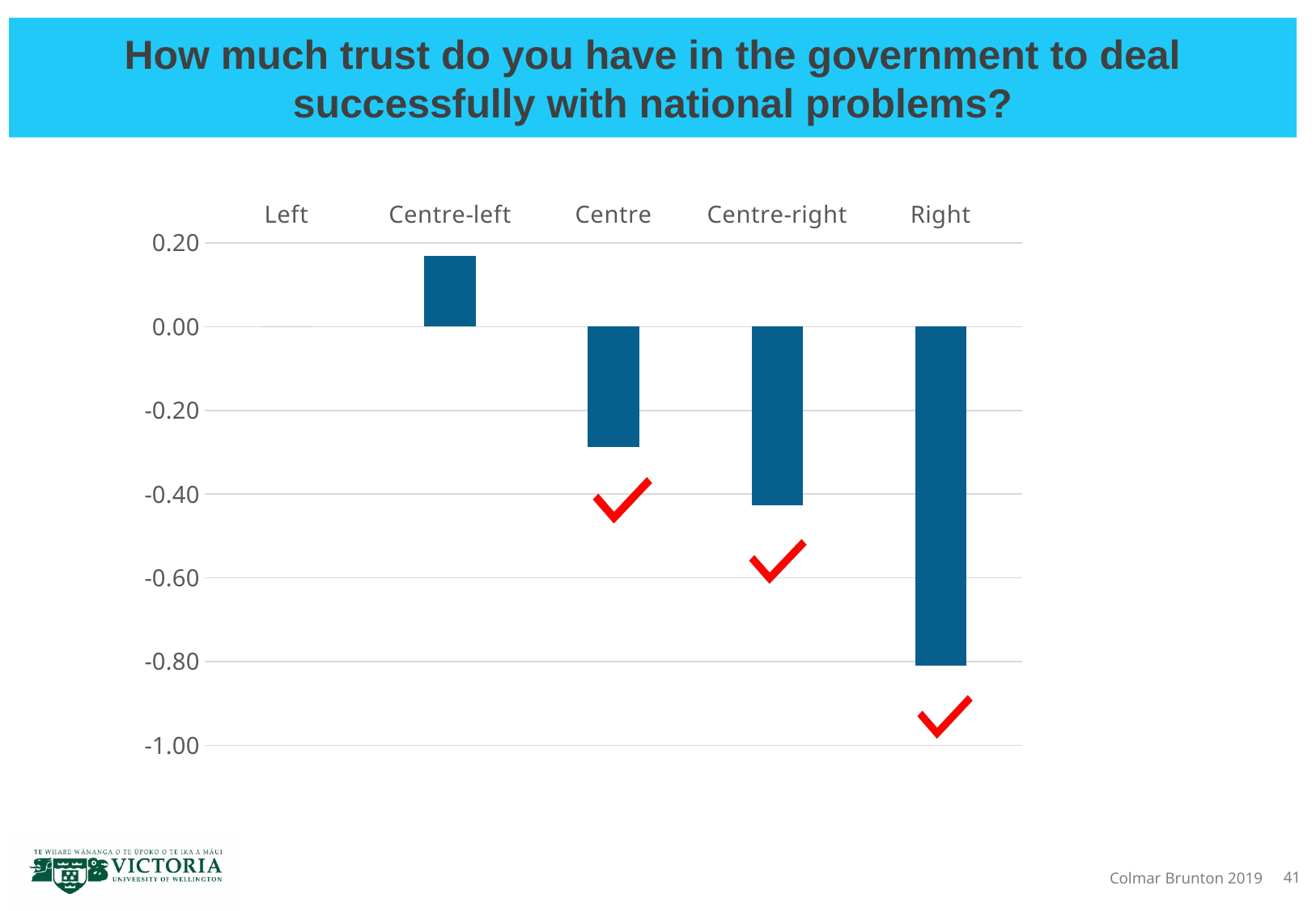
Do the values rise or fall moving from Centre-left to Right along the x axis? fall How many categories are shown along the x axis of the chart? 5 Is the value for Right greater or less than -0.60? less What is the title of the slide containing the chart? How much trust do you have in the government to deal successfully with national problems? Is the value for Right greater or less than -1.00? greater Is the value for Centre greater or less than -0.40? greater Which category has the lowest value in the chart? Right What kind of chart is shown on the slide? bar chart Which has the larger value, Centre or Centre-right? Centre Which category has the highest value in the chart? Centre-left